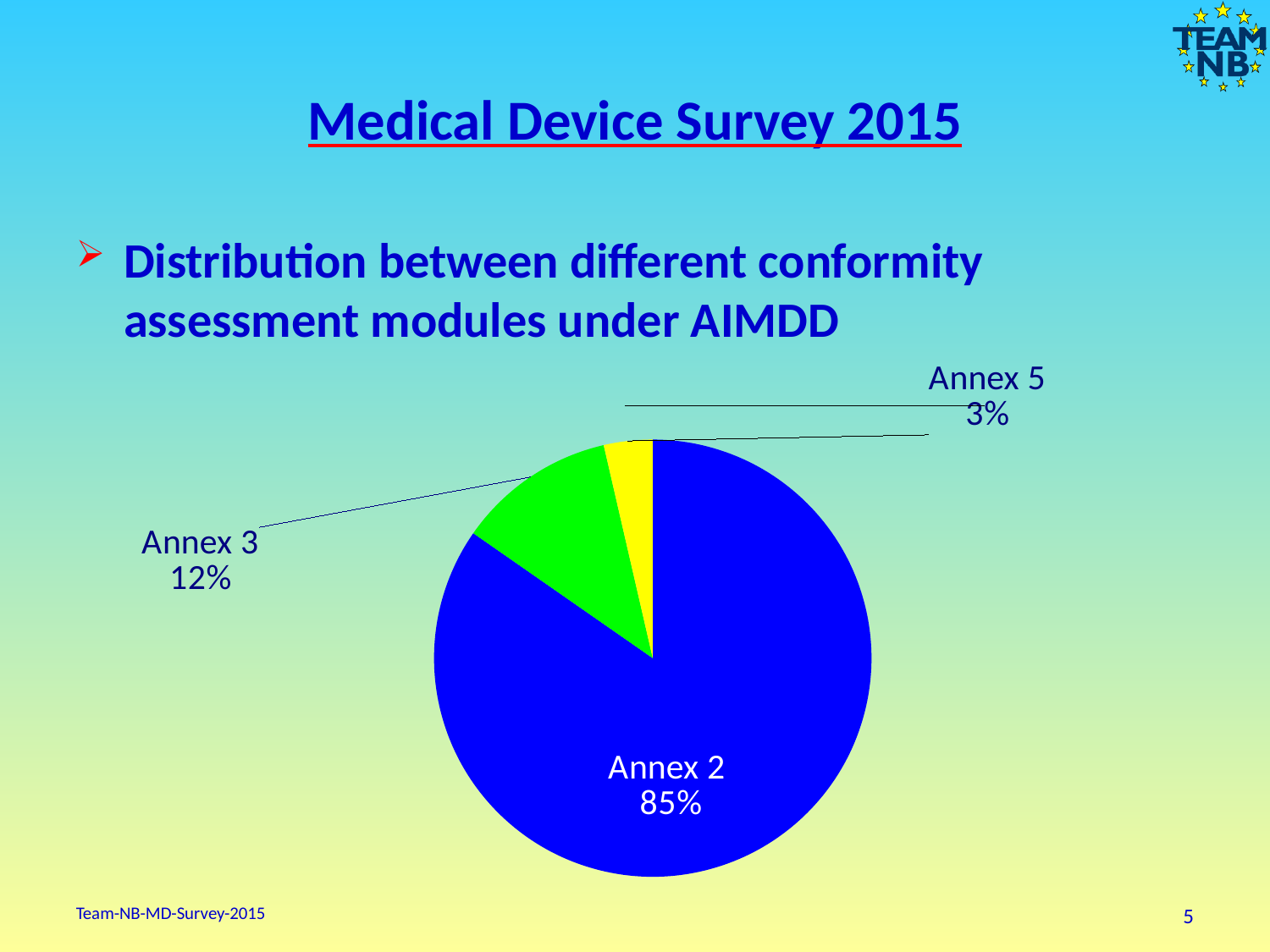
How many slices does the pie chart have? 3 What is the difference in percentage points between Annex 3 and Annex 5? 9 What colour is the Annex 2 slice? Blue Which annex has the largest share of the pie? Annex 2 What share of the pie does Annex 5 represent? 3% What share of the pie does Annex 2 represent? 85% What colour is the Annex 3 slice? Green What share of the pie does Annex 3 represent? 12% What kind of chart is shown on the slide? Pie chart Which annex has the smallest share of the pie? Annex 5 What is the difference in percentage points between Annex 2 and Annex 3? 73 Which is larger, the share for Annex 3 or the share for Annex 5? Annex 3